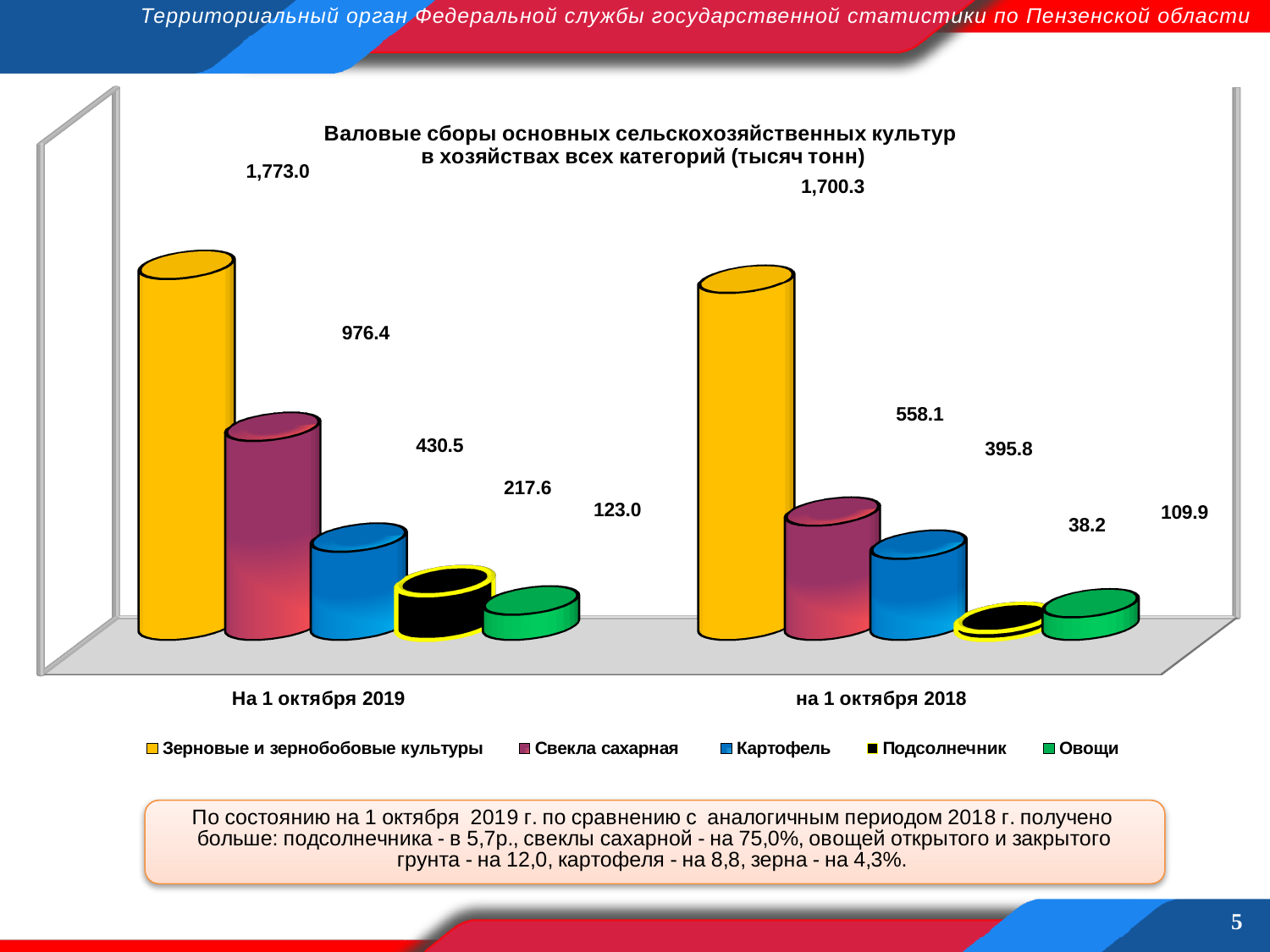
What is the value for Свекла сахарная on 1 October 2018? 558.1 What is the difference between the Картофель values on 1 October 2019 and 1 October 2018? 34.7 What is the value for Зерновые и зернобобовые культуры on 1 October 2019? 1,773.0 What colour represents Картофель in the chart? Blue How many series does the legend list? 5 Which series has the highest value on 1 October 2019? Зерновые и зернобобовые культуры How many categories are shown on the x axis? 2 Which is larger: Свекла сахарная on 1 October 2019 or Свекла сахарная on 1 October 2018? 1 October 2019 What is the value for Подсолнечник on 1 October 2019? 217.6 What is the value for Овощи on 1 October 2018? 109.9 What kind of chart is shown on the slide? Bar chart Which series has the lowest value on 1 October 2018? Подсолнечник